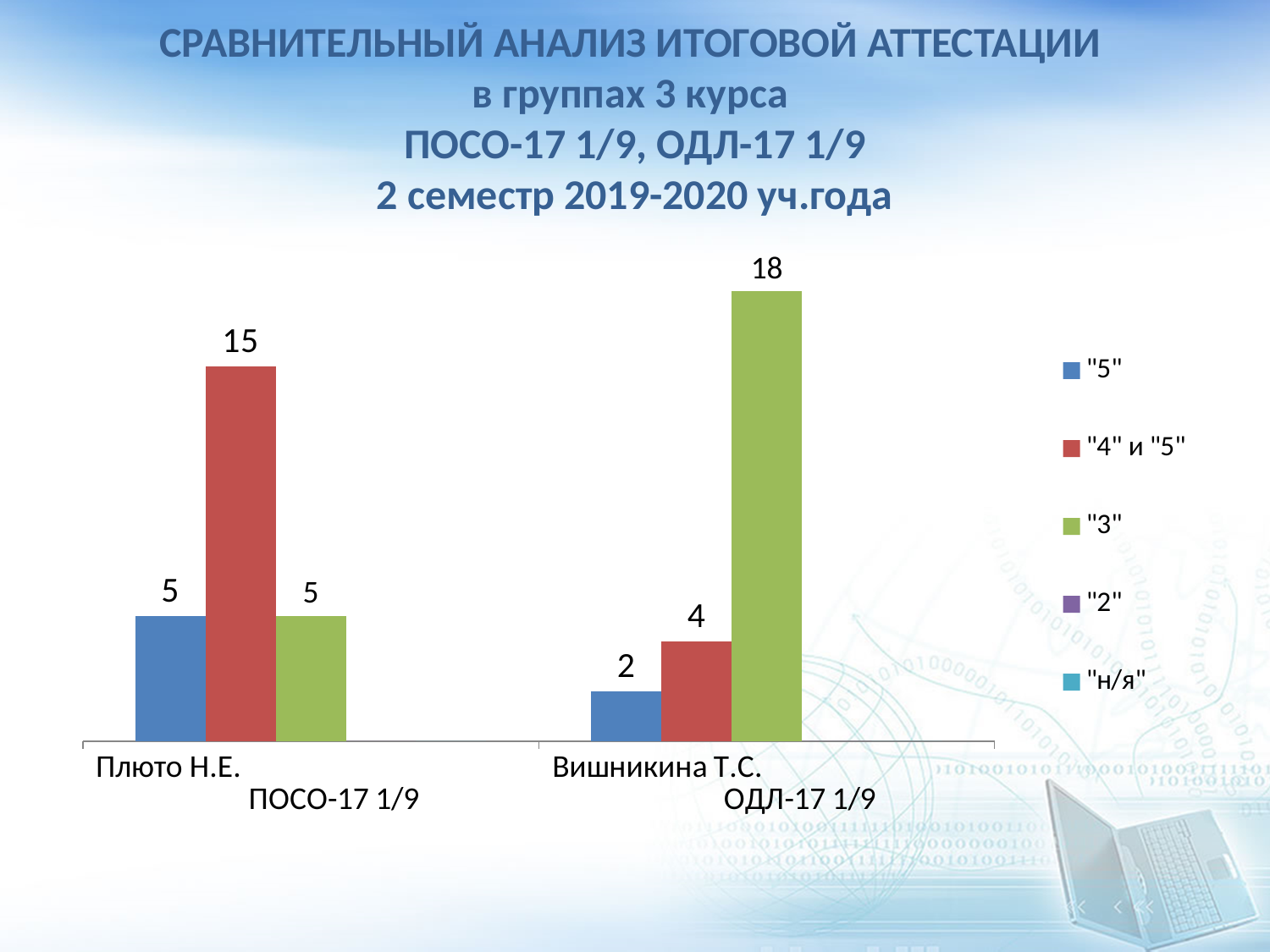
What is the value of the "5" series for Вишникина Т.С. ОДЛ-17 1/9? 2 How many series does the legend list? 5 What is the value of the "4" и "5" series for Плюто Н.Е. ПОСО-17 1/9? 15 What is the value of the "3" series for Вишникина Т.С. ОДЛ-17 1/9? 18 Which series has the highest value for Плюто Н.Е. ПОСО-17 1/9? "4" и "5" What colour represents the "3" series in the legend? green What kind of chart is shown on the slide? bar chart How many categories (groups) are shown on the x axis? 2 What is the value of the "4" и "5" series for Вишникина Т.С. ОДЛ-17 1/9? 4 Which is larger: the "4" и "5" value for Плюто Н.Е. ПОСО-17 1/9 or for Вишникина Т.С. ОДЛ-17 1/9? Плюто Н.Е. ПОСО-17 1/9 What is the difference between the "3" values for Вишникина Т.С. ОДЛ-17 1/9 and Плюто Н.Е. ПОСО-17 1/9? 13